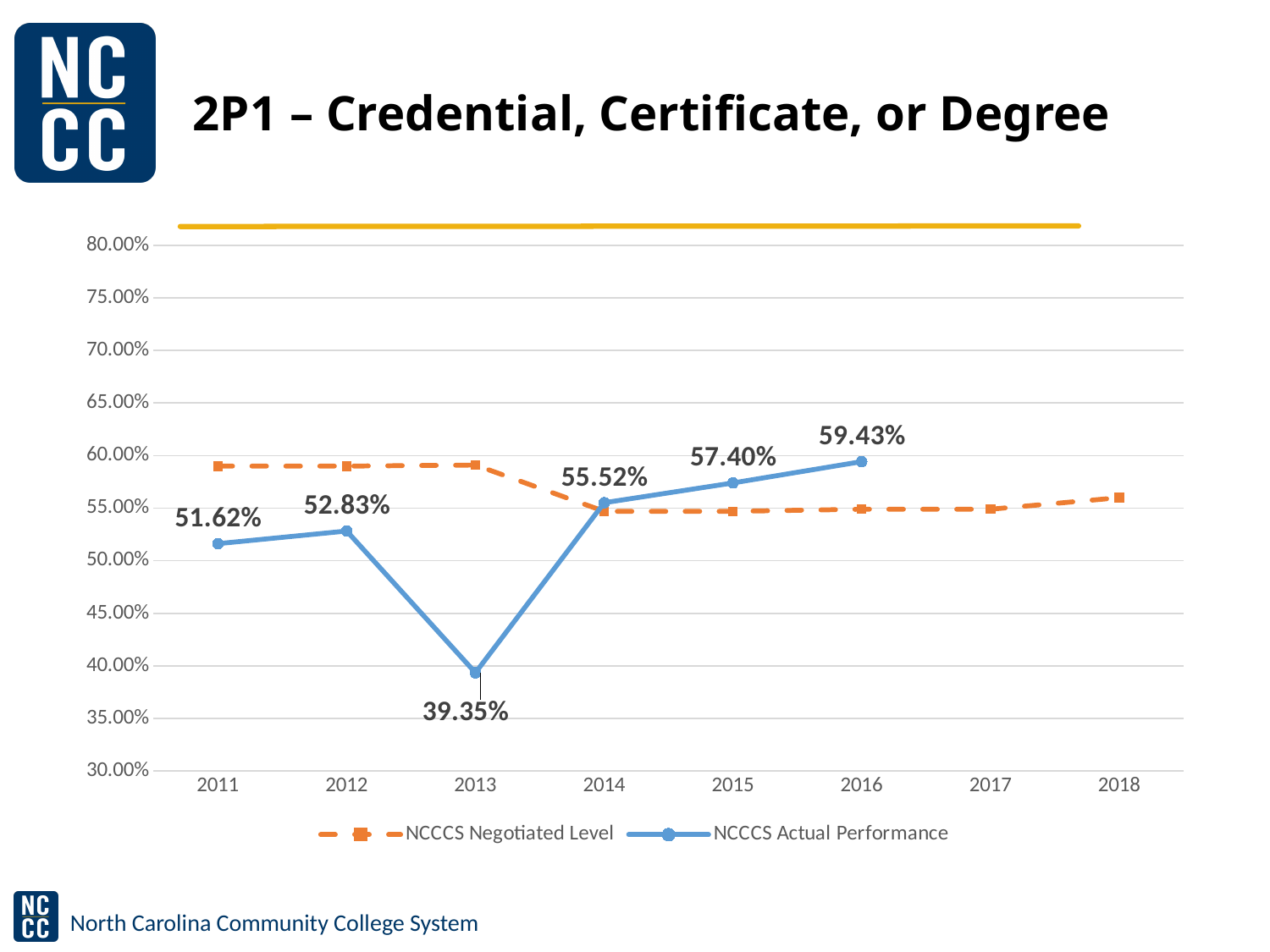
Is the NCCCS Negotiated Level for 2011 greater or less than 55.00%? greater How many series does the legend list? 2 Does NCCCS Actual Performance rise or fall from 2013 to 2016? Rises Which year has the higher NCCCS Actual Performance, 2012 or 2014? 2014 In which year is NCCCS Actual Performance lowest? 2013 By how many percentage points did NCCCS Actual Performance increase from 2015 to 2016? 2.03 percentage points What is the NCCCS Actual Performance value for 2016? 59.43% What is the NCCCS Actual Performance value for 2013? 39.35% What kind of chart is shown on the slide? Line chart Is the NCCCS Negotiated Level for 2015 greater or less than 60.00%? less What is the NCCCS Actual Performance value for 2011? 51.62% In which year is NCCCS Actual Performance highest? 2016